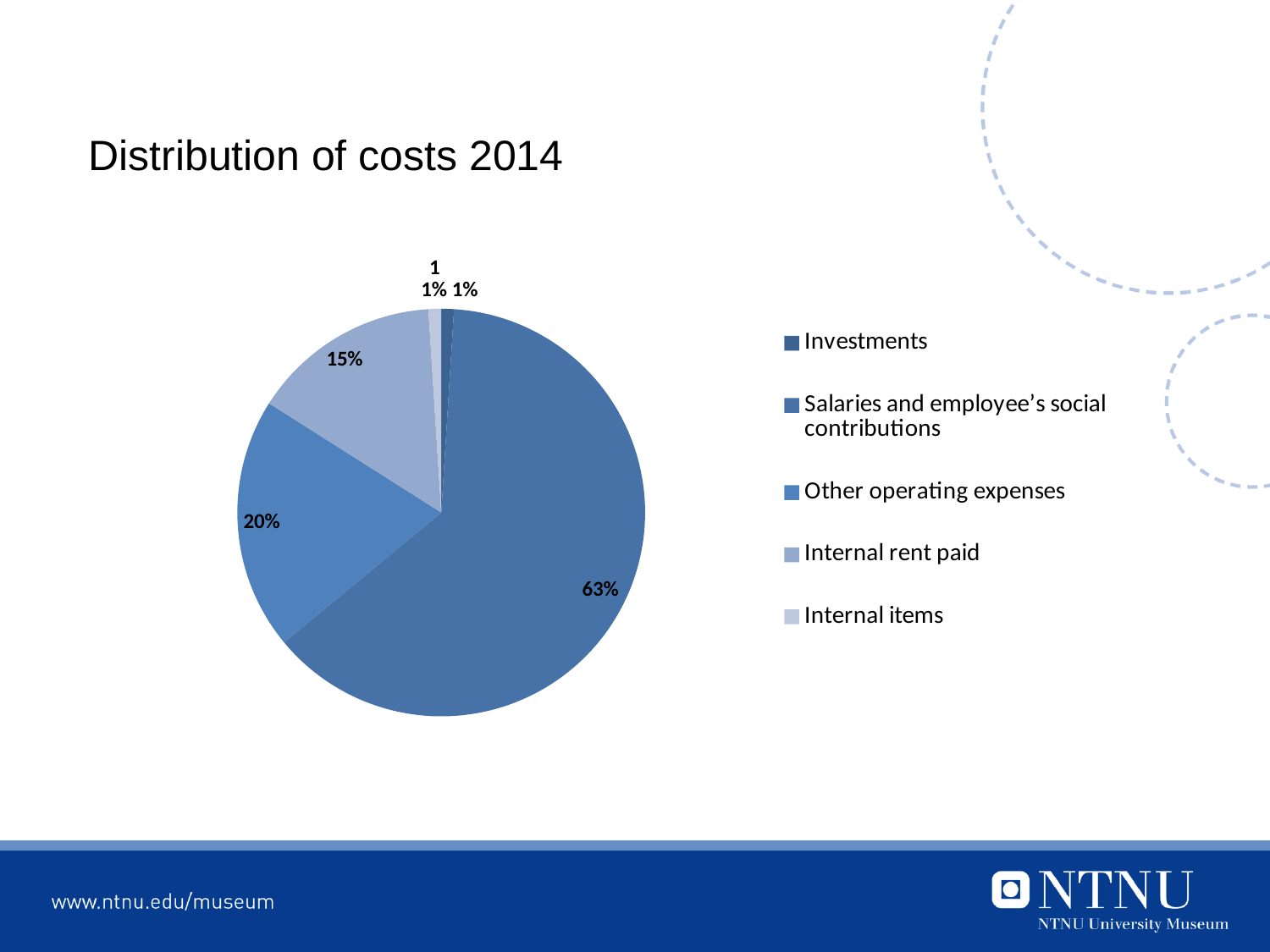
What is the difference in percentage points between the Salaries and employee's social contributions share and the Other operating expenses share? 43 percentage points Which is larger: the share for Other operating expenses or the share for Internal rent paid? Other operating expenses What share of costs is labelled for Salaries and employee's social contributions? 63% How many categories does the legend of the pie chart list? 5 How many slices does the pie chart have? 5 What is the difference in percentage points between the Other operating expenses share and the Internal rent paid share? 5 percentage points Which category has the largest share of the pie chart? Salaries and employee's social contributions What share of costs is labelled for Internal rent paid? 15% What kind of chart is shown on the slide? pie chart What share of costs is labelled for Other operating expenses? 20% What share of costs is labelled for Investments? 1% What is the title of the chart on the slide? Distribution of costs 2014